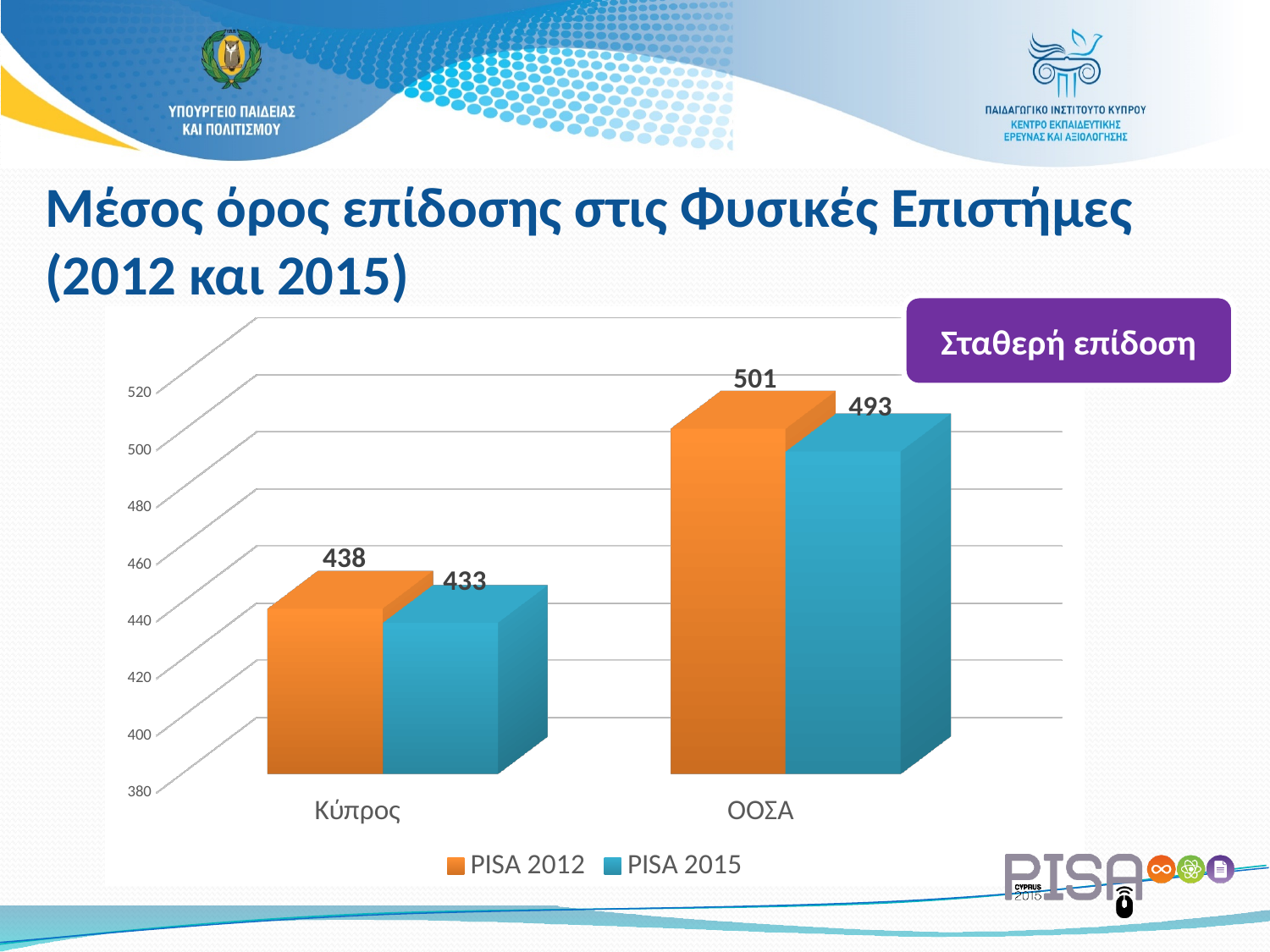
What is the PISA 2012 value for ΟΟΣΑ? 501 What is the difference between the PISA 2012 and PISA 2015 values for ΟΟΣΑ? 8 How many series does the legend list? 2 What is the PISA 2015 value for ΟΟΣΑ? 493 What is the difference between the PISA 2012 values for ΟΟΣΑ and Κύπρος? 63 What is the PISA 2015 value for Κύπρος? 433 How many categories are shown on the x axis? 2 What kind of chart is shown on the slide? Bar chart Which category has the lowest PISA 2015 value? Κύπρος What is the PISA 2012 value for Κύπρος? 438 Which is larger: the PISA 2015 value for Κύπρος or the PISA 2015 value for ΟΟΣΑ? ΟΟΣΑ Which category has the highest PISA 2012 value? ΟΟΣΑ